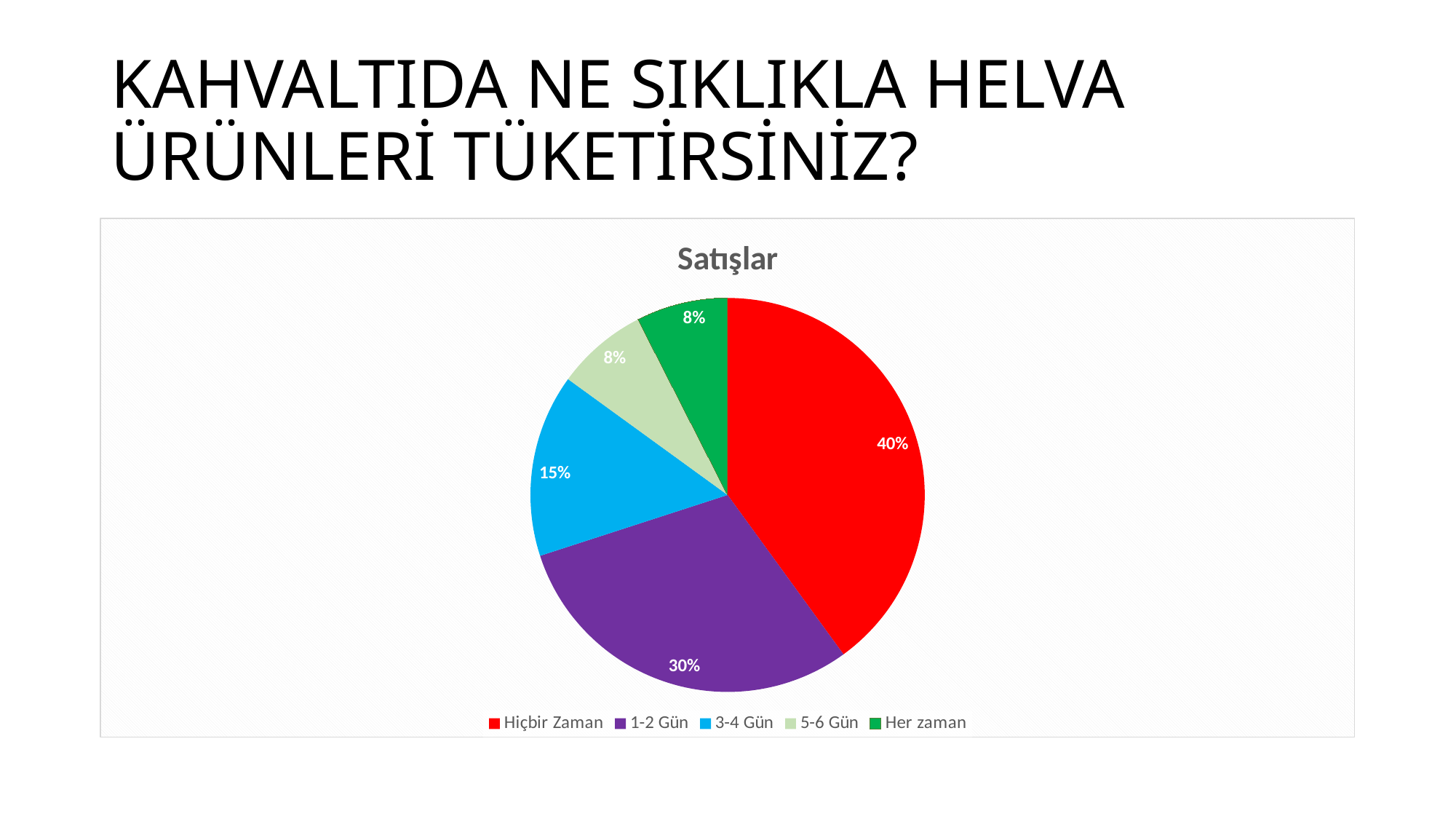
What is the chart's title? Satışlar What share of the pie does 5-6 Gün have? 8% What share of the pie does Hiçbir Zaman have? 40% What share of the pie does 3-4 Gün have? 15% How many categories does the legend list? 5 What kind of chart is shown on the slide? pie chart Which is larger, the share for 1-2 Gün or the share for 3-4 Gün? 1-2 Gün Which category has the largest slice of the pie? Hiçbir Zaman What is the difference between the shares of Hiçbir Zaman and 1-2 Gün? 10% What colour is the slice for 3-4 Gün? light blue